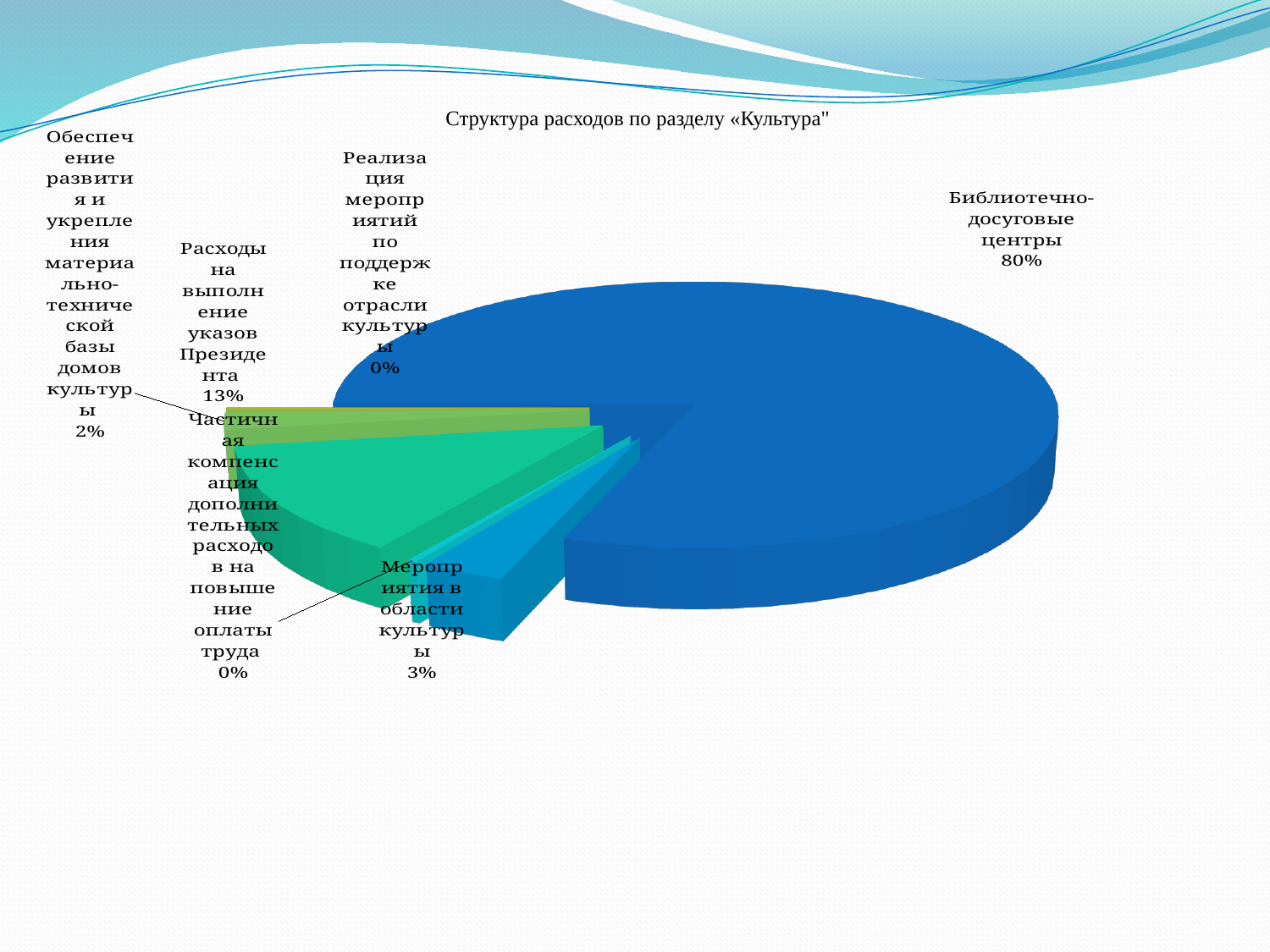
What share of expenses goes to Мероприятия в области культуры? 3% What share is shown for Реализация мероприятий по поддержке отрасли культуры? 0% What is the difference in percentage points between Библиотечно-досуговые центры and Расходы на выполнение указов Президента? 67 What is the combined share of Расходы на выполнение указов Президента and Мероприятия в области культуры? 16% What share of expenses goes to Библиотечно-досуговые центры? 80% What share of expenses goes to Обеспечение развития и укрепления материально-технической базы домов культуры? 2% Which is larger: the share for Мероприятия в области культуры or the share for Обеспечение развития и укрепления материально-технической базы домов культуры? Мероприятия в области культуры What is the title of the chart? Структура расходов по разделу «Культура" How many categories are shown in the pie chart? 6 Which category has the largest share of the pie? Библиотечно-досуговые центры What share of expenses goes to Расходы на выполнение указов Президента? 13% What kind of chart is shown on the slide? pie chart